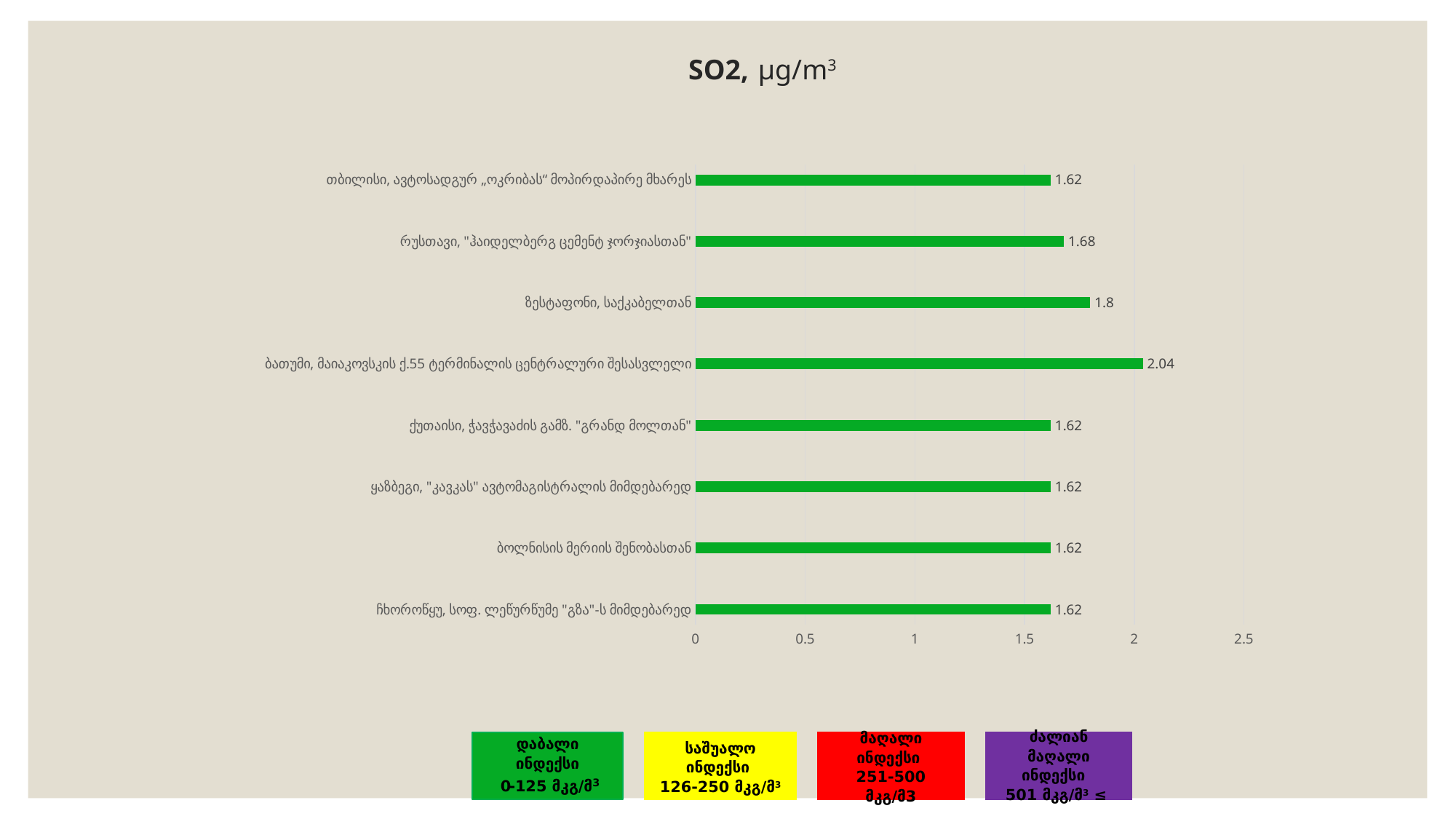
What is the SO2 value for ზესტაფონი, საქკაბელთან? 1.8 Which location has the highest SO2 value? ბათუმი, მაიაკოვსკის ქ.55 ტერმინალის ცენტრალური შესასვლელი What is the difference between the SO2 values for ბათუმი, მაიაკოვსკის ქ.55 ტერმინალის ცენტრალური შესასვლელი and თბილისი, ავტოსადგურ „ოკრიბას“ მოპირდაპირე მხარეს? 0.42 What is the SO2 value for ბათუმი, მაიაკოვსკის ქ.55 ტერმინალის ცენტრალური შესასვლელი? 2.04 What is the title of the chart? SO2, μg/m³ What type of chart is shown on the slide? bar chart What is the difference between the SO2 values for ზესტაფონი, საქკაბელთან and რუსთავი, "ჰაიდელბერგ ცემენტ ჯორჯიასთან"? 0.12 Is the SO2 value for ბათუმი, მაიაკოვსკის ქ.55 ტერმინალის ცენტრალური შესასვლელი greater or less than 2? greater How many locations are shown in the chart? 8 Which has a larger SO2 value: ზესტაფონი, საქკაბელთან or რუსთავი, "ჰაიდელბერგ ცემენტ ჯორჯიასთან"? ზესტაფონი, საქკაბელთან What is the SO2 value for ბოლნისის მერიის შენობასთან? 1.62 What is the SO2 value for რუსთავი, "ჰაიდელბერგ ცემენტ ჯორჯიასთან"? 1.68